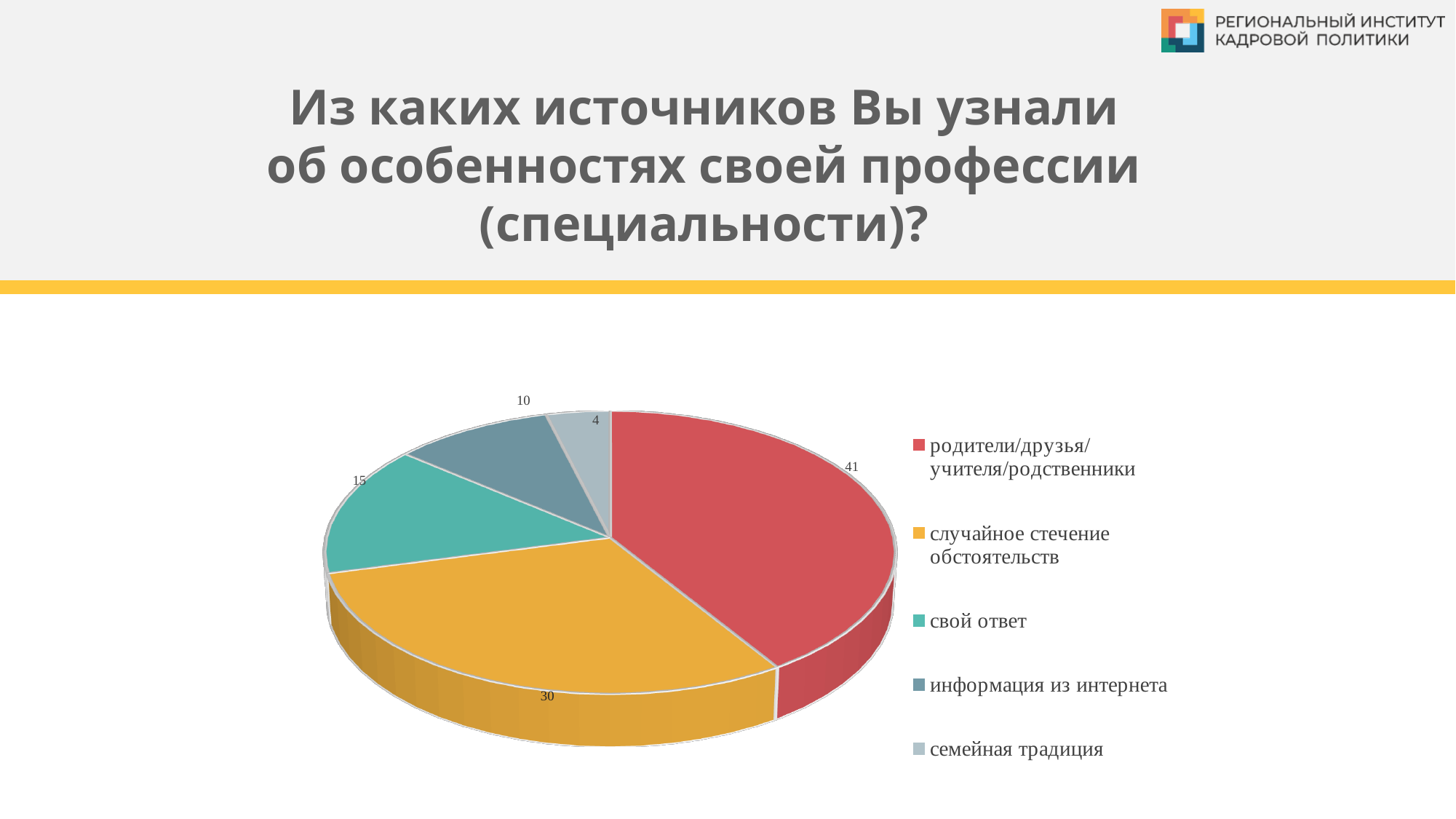
What is the value for "информация из интернета"? 10 What is the value for "случайное стечение обстоятельств"? 30 What colour is the slice for "случайное стечение обстоятельств"? yellow Which category has the largest slice of the pie? родители/друзья/учителя/родственники What is the value for "семейная традиция"? 4 How many categories does the pie chart have? 5 What is the value for "свой ответ"? 15 Which is larger: the value for "свой ответ" or the value for "информация из интернета"? свой ответ What kind of chart is shown on the slide? pie chart What is the value for "родители/друзья/учителя/родственники"? 41 Which category has the smallest slice of the pie? семейная традиция What is the difference between the values for "родители/друзья/учителя/родственники" and "случайное стечение обстоятельств"? 11